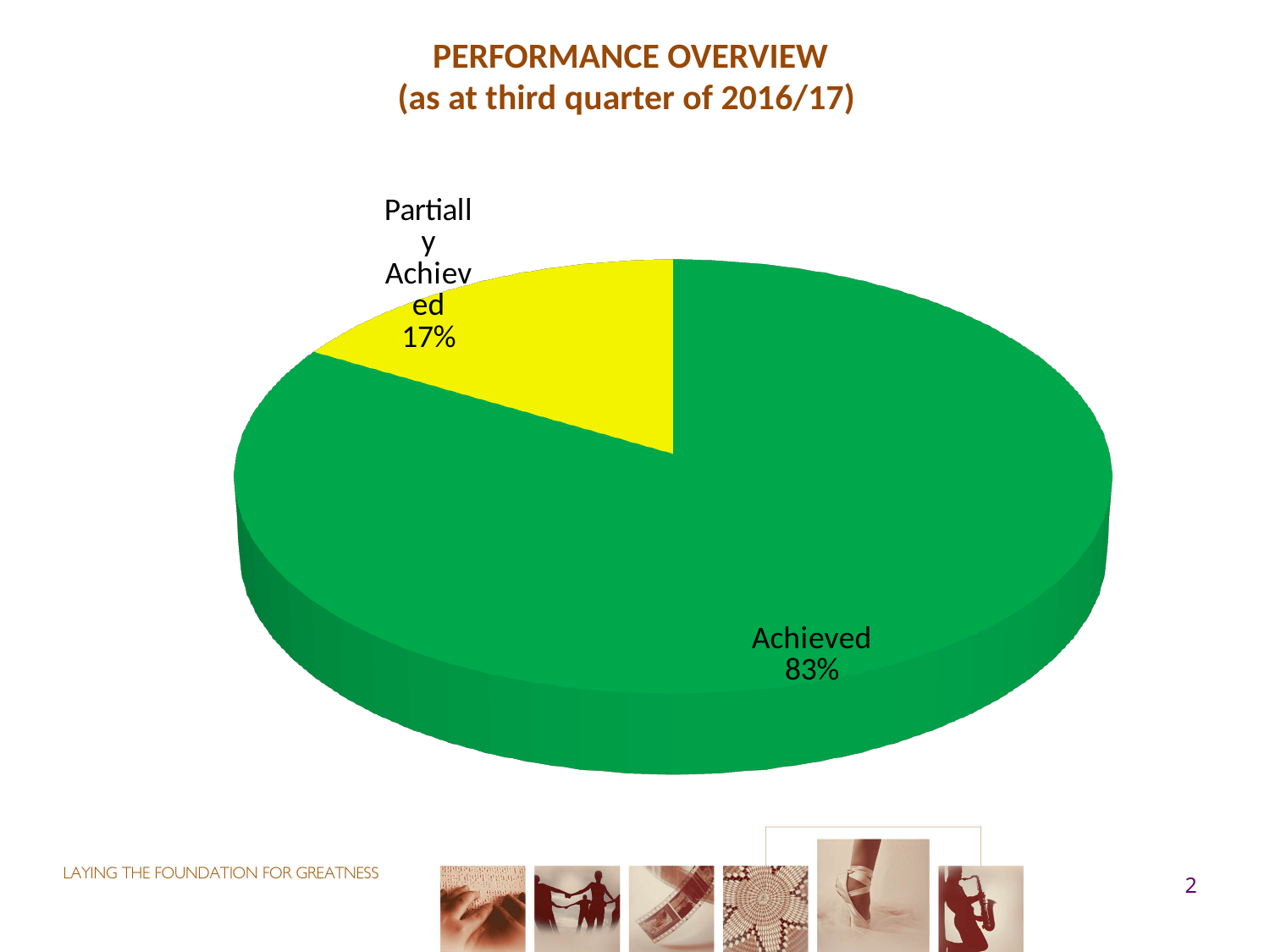
What is the difference in percentage points between the Achieved and Partially Achieved slices? 66 Which slice of the pie is the largest? Achieved What percentage of the pie is labelled Achieved? 83% What is the title of the chart? PERFORMANCE OVERVIEW (as at third quarter of 2016/17) What colour is the Achieved slice? green Which slice of the pie is the smallest? Partially Achieved Which is larger, the Achieved slice or the Partially Achieved slice? Achieved What kind of chart is shown on the slide? pie chart What percentage of the pie is labelled Partially Achieved? 17% How many slices does the pie chart have? 2